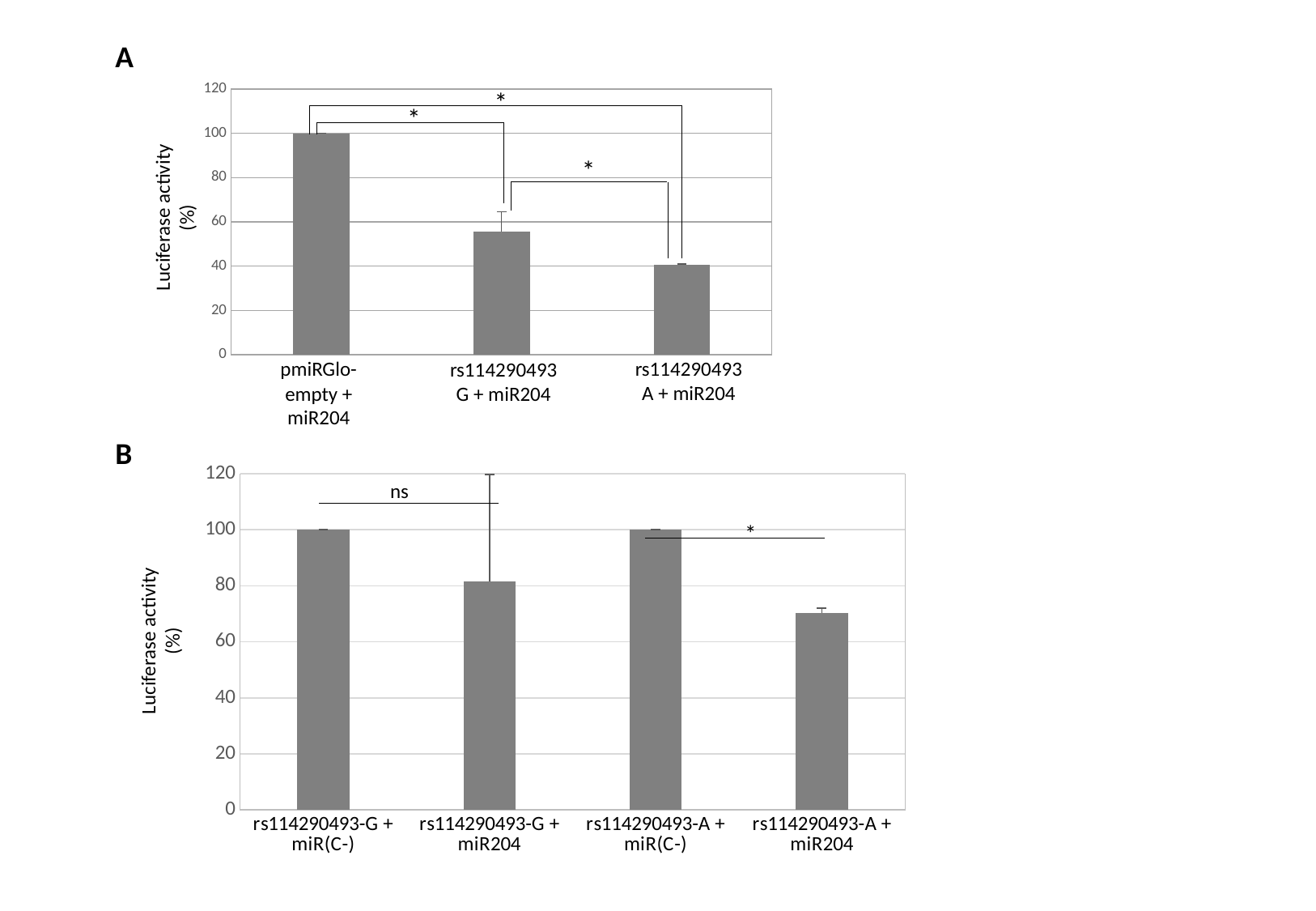
In chart B, which category has the lowest luciferase activity? rs114290493-A + miR204 In chart B, is the value for rs114290493-A + miR204 greater or less than 80? less What is the y-axis label of chart B? Luciferase activity (%) What kind of chart is chart A? bar chart In chart B, is the value for rs114290493-G + miR204 greater or less than 60? greater In chart A, is the value for rs114290493 G + miR204 greater or less than 80? less In chart A, which category has the highest luciferase activity? pmiRGlo-empty + miR204 In chart A, which is larger: rs114290493 G + miR204 or rs114290493 A + miR204? rs114290493 G + miR204 In chart A, which category has the lowest luciferase activity? rs114290493 A + miR204 How many bars are shown in chart A? 3 How many bars are shown in chart B? 4